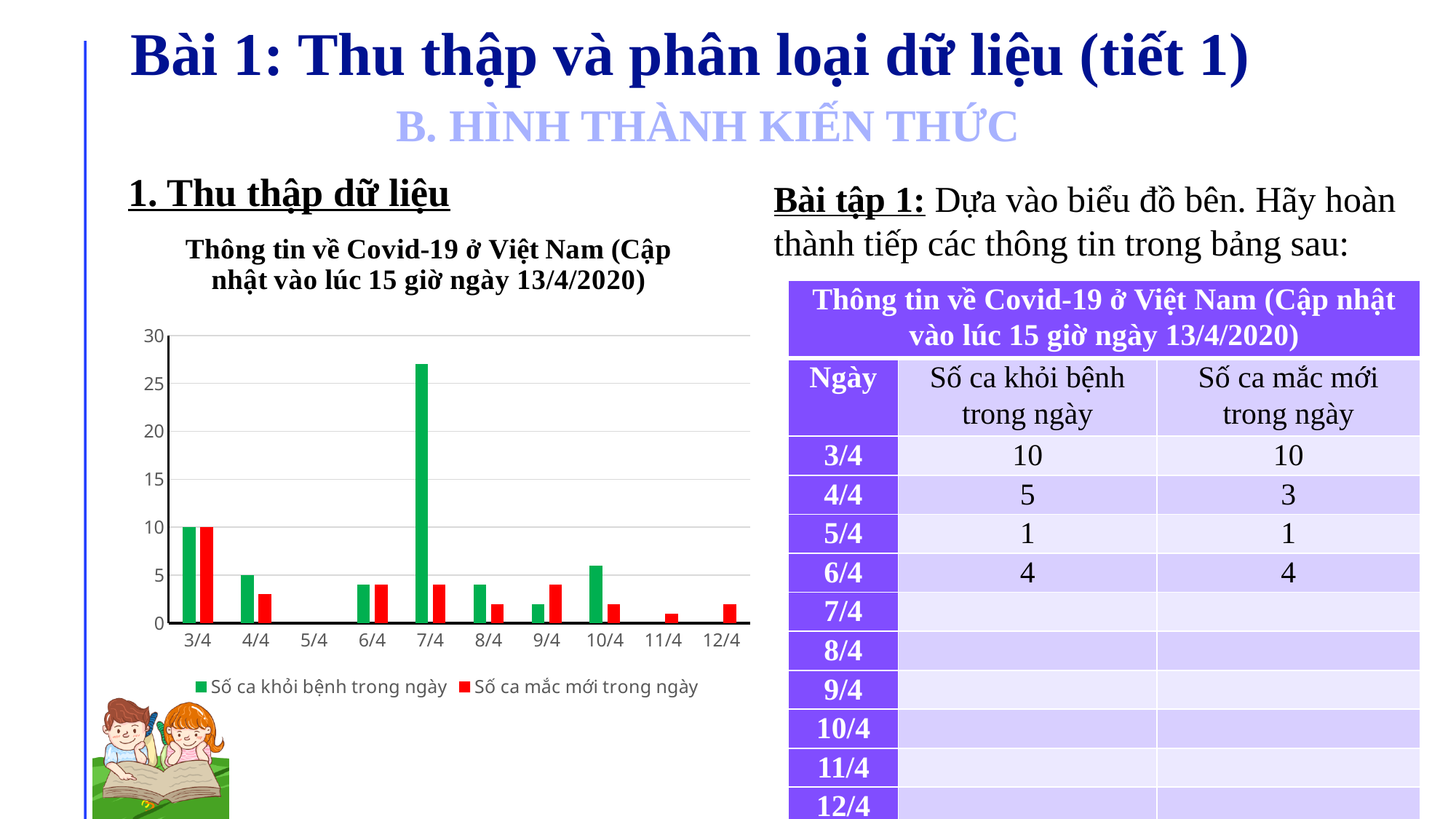
Which is larger on 9/4: 'Số ca khỏi bệnh trong ngày' or 'Số ca mắc mới trong ngày'? Số ca mắc mới trong ngày Which colour represents 'Số ca khỏi bệnh trong ngày' in the chart legend? green What kind of chart is shown on the slide? bar chart Is the value for 'Số ca khỏi bệnh trong ngày' on 7/4 greater or less than 25? greater Is the value for 'Số ca mắc mới trong ngày' on 8/4 greater or less than 5? less What is the value for 'Số ca mắc mới trong ngày' on 3/4? 10 What is the value for 'Số ca khỏi bệnh trong ngày' on 3/4? 10 What is the value for 'Số ca khỏi bệnh trong ngày' on 4/4? 5 How many dates are shown along the x axis of the chart? 10 How many series does the chart legend list? 2 On which date is the value for 'Số ca khỏi bệnh trong ngày' highest? 7/4 On which date is the value for 'Số ca mắc mới trong ngày' highest? 3/4